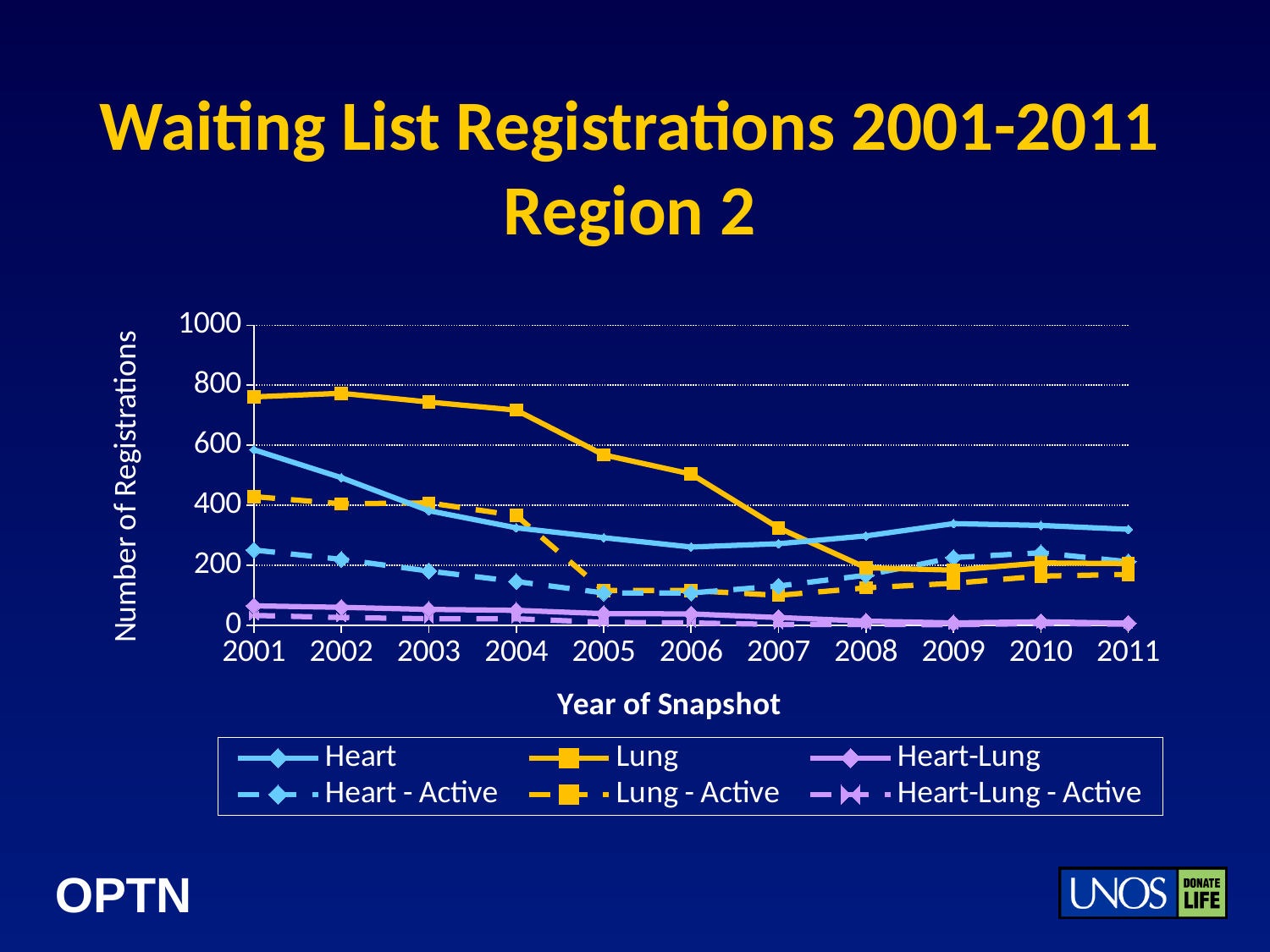
What is the label of the x axis? Year of Snapshot Which series has the highest value in 2001? Lung Is the value for Lung in 2001 greater or less than 600? greater Which series has the lowest value in 2001? Heart-Lung - Active In 2011, which is larger, the Heart value or the Lung value? Heart Is the value for Lung in 2006 greater or less than 400? greater How many years are plotted along the x axis? 11 How many series does the legend list? 6 Does the Lung series rise or fall from 2001 to 2011? fall Is the value for Heart-Lung in 2011 greater or less than 200? less What kind of chart is shown on the slide? line chart